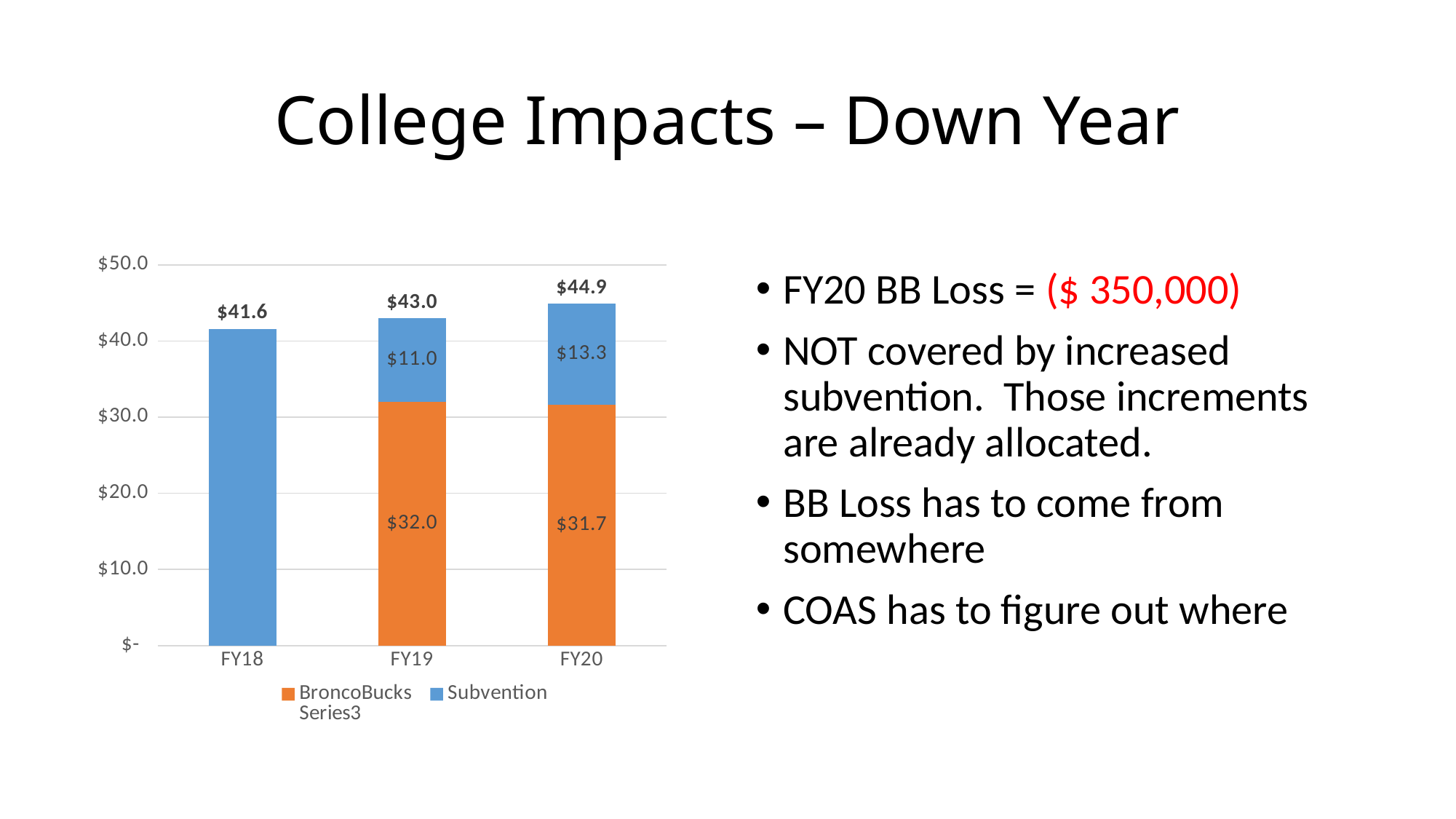
What is the total labelled on top of the FY19 bar? $43.0 What is the BroncoBucks value for FY20? $31.7 Which fiscal year has the highest total bar? FY20 What is the Subvention value for FY20? $13.3 Which fiscal year has the lowest total bar? FY18 Which year has the larger BroncoBucks value, FY19 or FY20? FY19 How many fiscal years are shown on the x axis? 3 Do the bar totals rise or fall from FY18 to FY20? rise What is the BroncoBucks value for FY19? $32.0 What is the Subvention value for FY19? $11.0 By how much does the Subvention value increase from FY19 to FY20? $2.3 What is the total labelled on top of the FY20 bar? $44.9